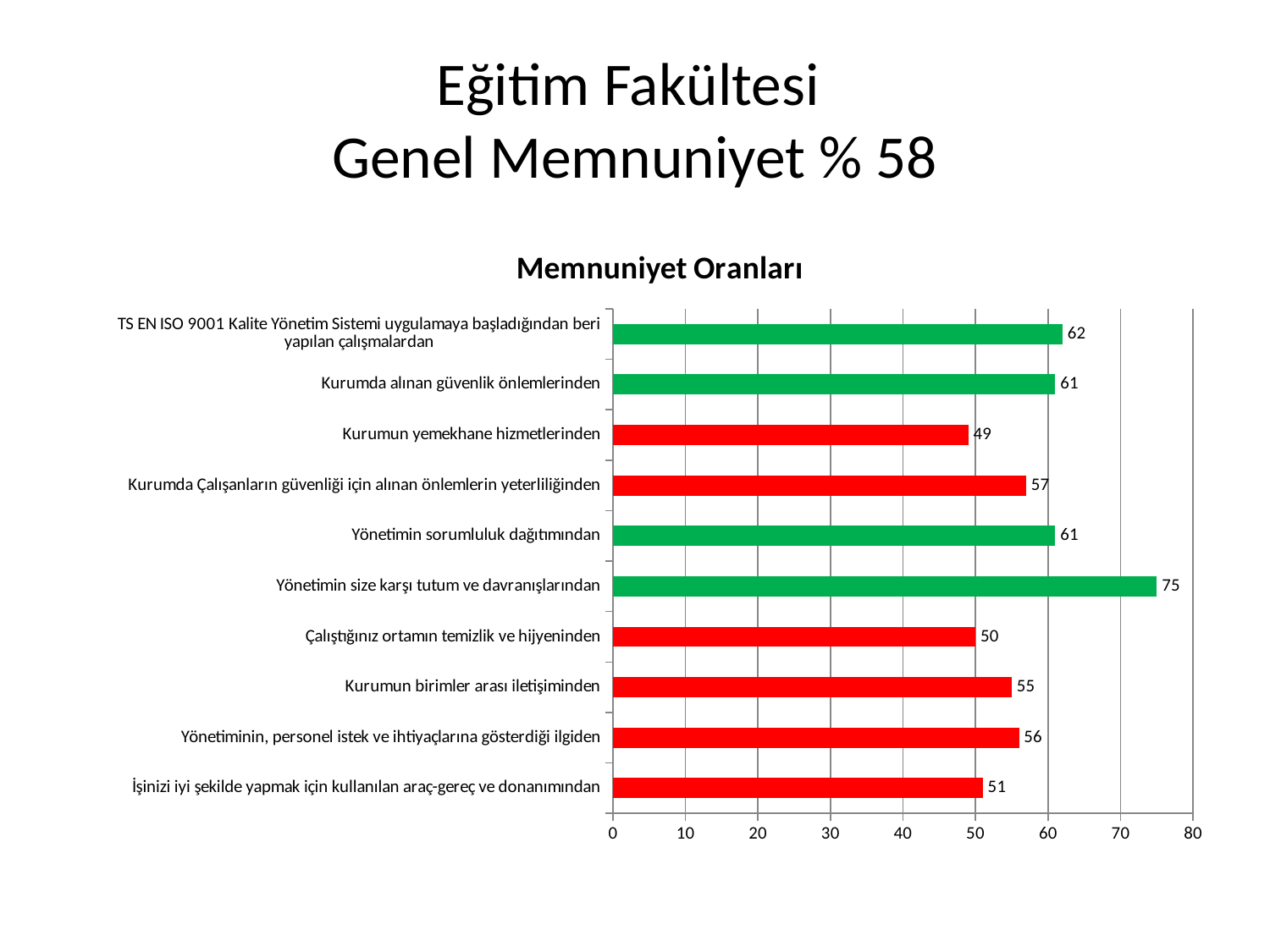
Which category has the highest value? Yönetimin size karşı tutum ve davranışlarından What kind of chart is shown on the slide? bar chart Which category has the lowest value? Kurumun yemekhane hizmetlerinden Which is larger: the value for "Kurumda alınan güvenlik önlemlerinden" or the value for "Çalıştığınız ortamın temizlik ve hijyeninden"? Kurumda alınan güvenlik önlemlerinden How many categories are shown in the chart? 10 What is the value for "Yönetimin size karşı tutum ve davranışlarından"? 75 Is the value for "Yönetiminin, personel istek ve ihtiyaçlarına gösterdiği ilgiden" greater or less than 60? less What is the title of the chart? Memnuniyet Oranları What is the difference between the values for "TS EN ISO 9001 Kalite Yönetim Sistemi uygulamaya başladığından beri yapılan çalışmalardan" and "İşinizi iyi şekilde yapmak için kullanılan araç-gereç ve donanımından"? 11 What is the value for "Kurumun yemekhane hizmetlerinden"? 49 What is the value for "Kurumun birimler arası iletişiminden"? 55 What is the difference between the values for "Yönetimin size karşı tutum ve davranışlarından" and "Kurumun yemekhane hizmetlerinden"? 26